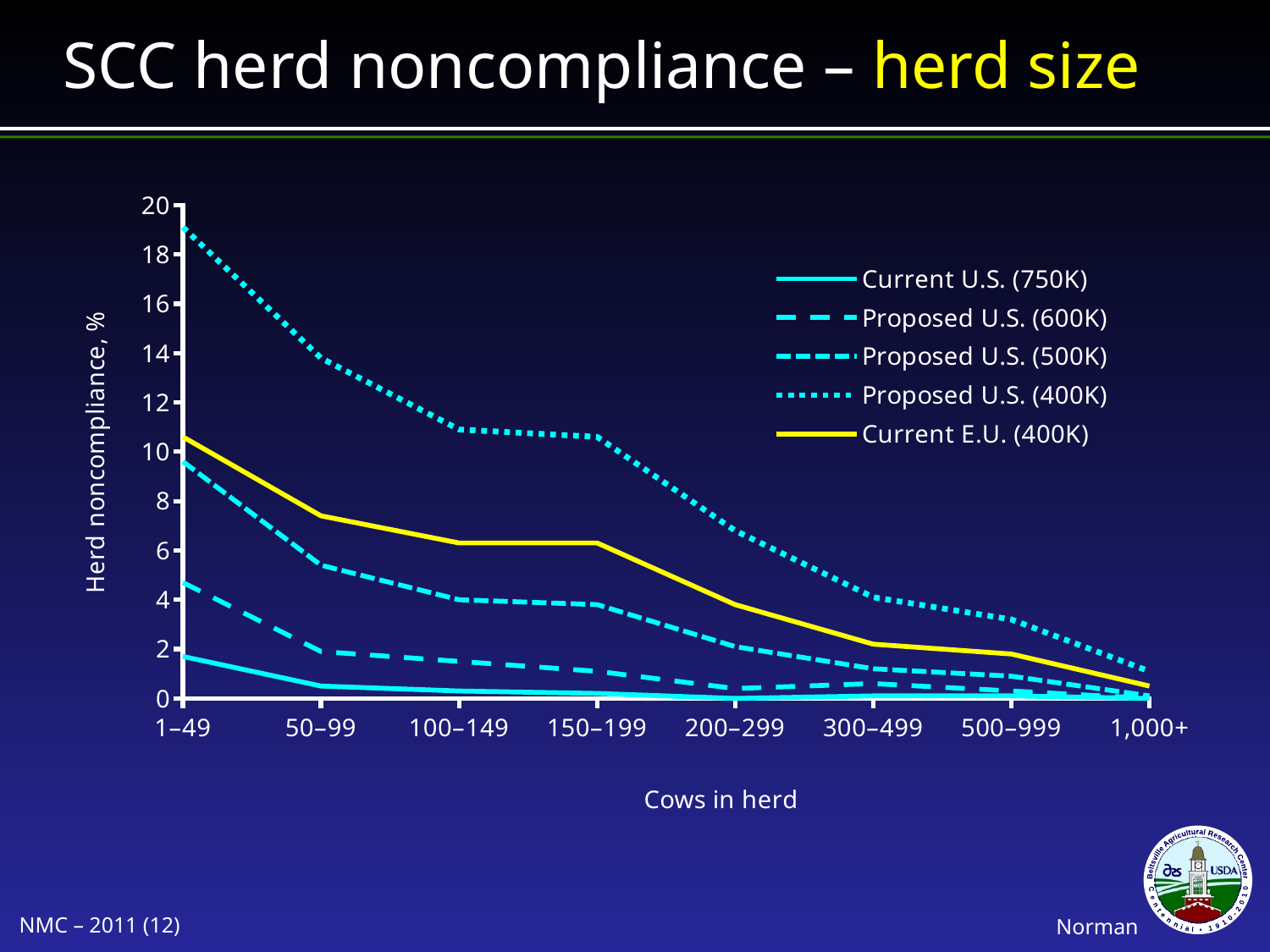
Do the values for Proposed U.S. (400K) rise or fall as herd size increases along the x axis? Fall Which series has the lowest herd noncompliance for the 1–49 cows category? Current U.S. (750K) At 1–49 cows, which is larger: Current E.U. (400K) or Proposed U.S. (500K)? Current E.U. (400K) How many herd-size categories are shown on the x axis? 8 What is the label of the x axis? Cows in herd How many series does the legend list? 5 What kind of chart is shown on the slide? Line chart Is the value for Proposed U.S. (400K) at 1–49 cows greater or less than 18? greater Is the value for Current E.U. (400K) at 50–99 cows greater or less than 8? less Is the value for Proposed U.S. (500K) at 1–49 cows greater or less than 10? less Which series has the highest herd noncompliance for the 1–49 cows category? Proposed U.S. (400K)